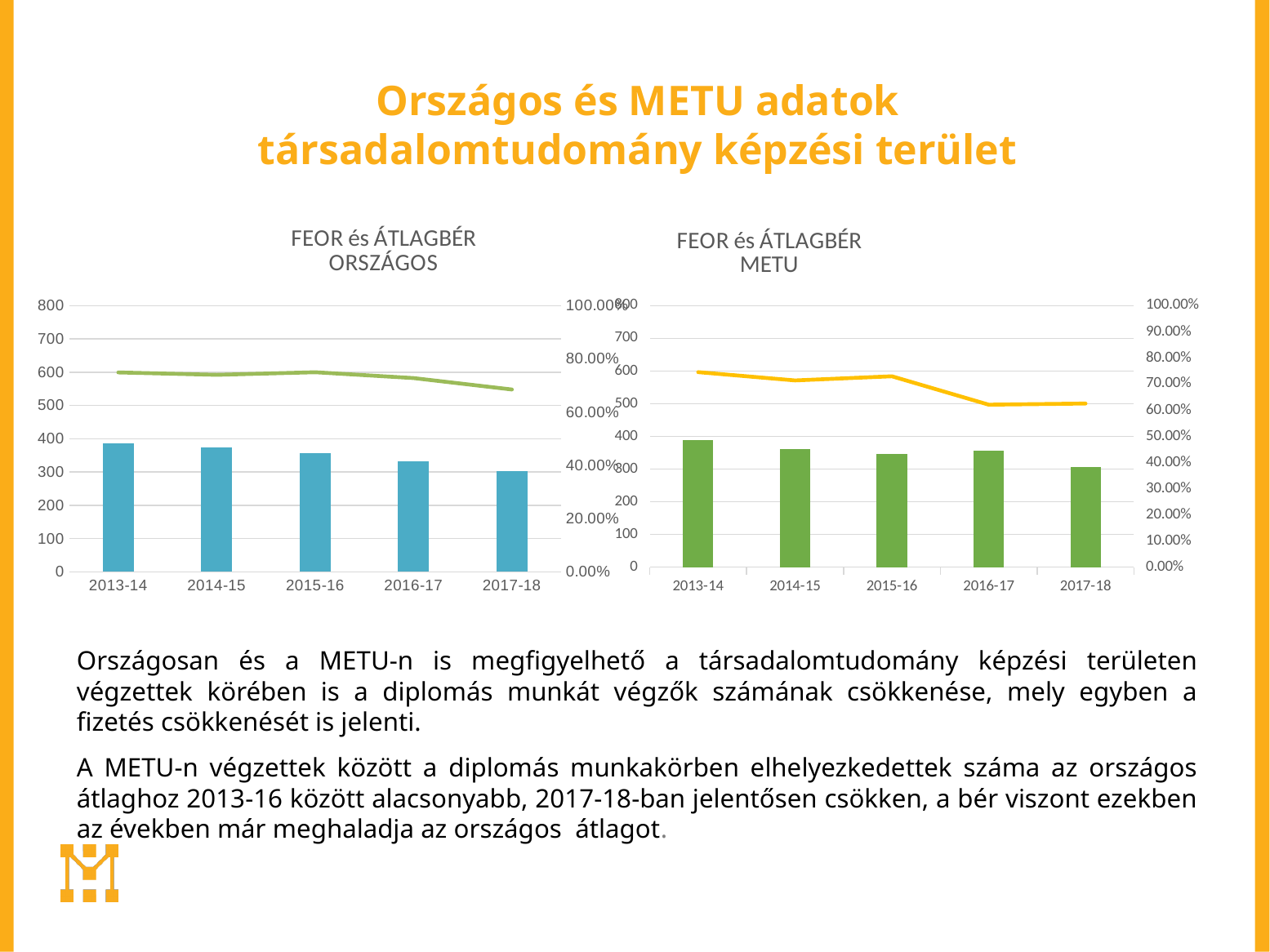
What kind of chart is the left chart titled 'FEOR és ÁTLAGBÉR ORSZÁGOS'? A bar chart combined with a line In the right chart (FEOR és ÁTLAGBÉR METU), which year has the shortest bar? 2017-18 In the left chart (FEOR és ÁTLAGBÉR ORSZÁGOS), which year has the tallest bar? 2013-14 In the left chart (FEOR és ÁTLAGBÉR ORSZÁGOS), is the bar value for 2017-18 greater or less than 400? less In the right chart (FEOR és ÁTLAGBÉR METU), does the line overall rise or fall from 2013-14 to 2017-18? fall In the left chart (FEOR és ÁTLAGBÉR ORSZÁGOS), how many academic years are shown on the x axis? 5 What colour are the bars in the right chart (FEOR és ÁTLAGBÉR METU)? Green In the left chart (FEOR és ÁTLAGBÉR ORSZÁGOS), which year has the shortest bar? 2017-18 In the right chart (FEOR és ÁTLAGBÉR METU), is the bar value for 2013-14 greater or less than 300? greater In the left chart (FEOR és ÁTLAGBÉR ORSZÁGOS), do the bar values rise or fall from 2013-14 to 2017-18? fall In the right chart (FEOR és ÁTLAGBÉR METU), which year has the tallest bar? 2013-14 In the right chart (FEOR és ÁTLAGBÉR METU), which bar is taller, 2014-15 or 2017-18? 2014-15